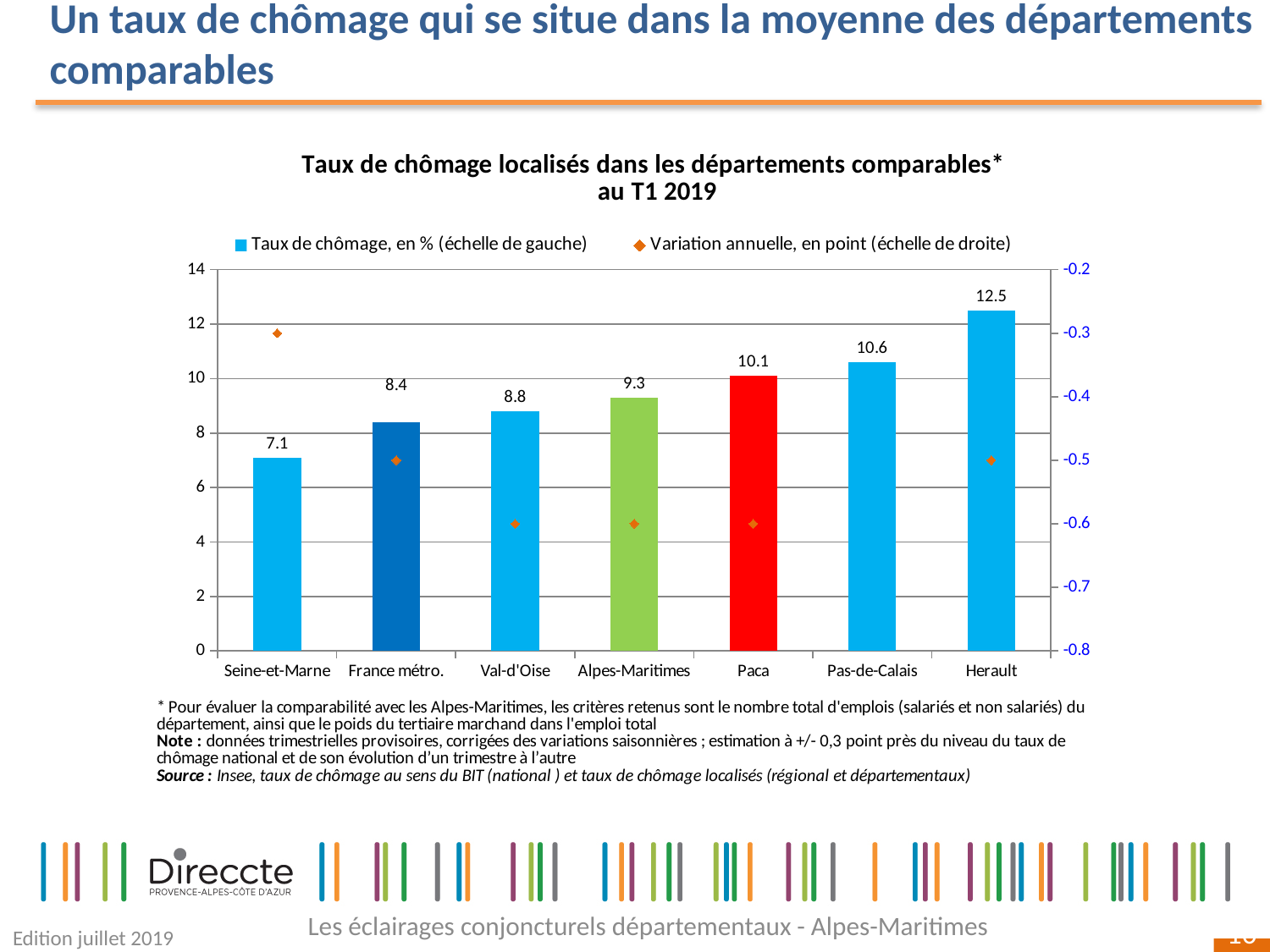
What kind of chart is used to show the unemployment rates? Bar chart Which department has the highest unemployment rate in the chart? Herault What is the unemployment rate (Taux de chômage, en %) shown for Herault? 12.5 What is the unemployment rate shown for France métro.? 8.4 How many categories are shown on the x axis of the chart? 7 According to the legend, which axis is used for the 'Variation annuelle, en point' series? Right axis (échelle de droite) Which has a higher unemployment rate, Pas-de-Calais or Val-d'Oise? Pas-de-Calais Do the unemployment rate bars rise or fall from left to right along the x axis? Rise What is the unemployment rate shown for Alpes-Maritimes? 9.3 What is the difference in unemployment rate between Paca and Alpes-Maritimes? 0.8 How many series does the chart legend list? 2 Which category has the lowest unemployment rate in the chart? Seine-et-Marne